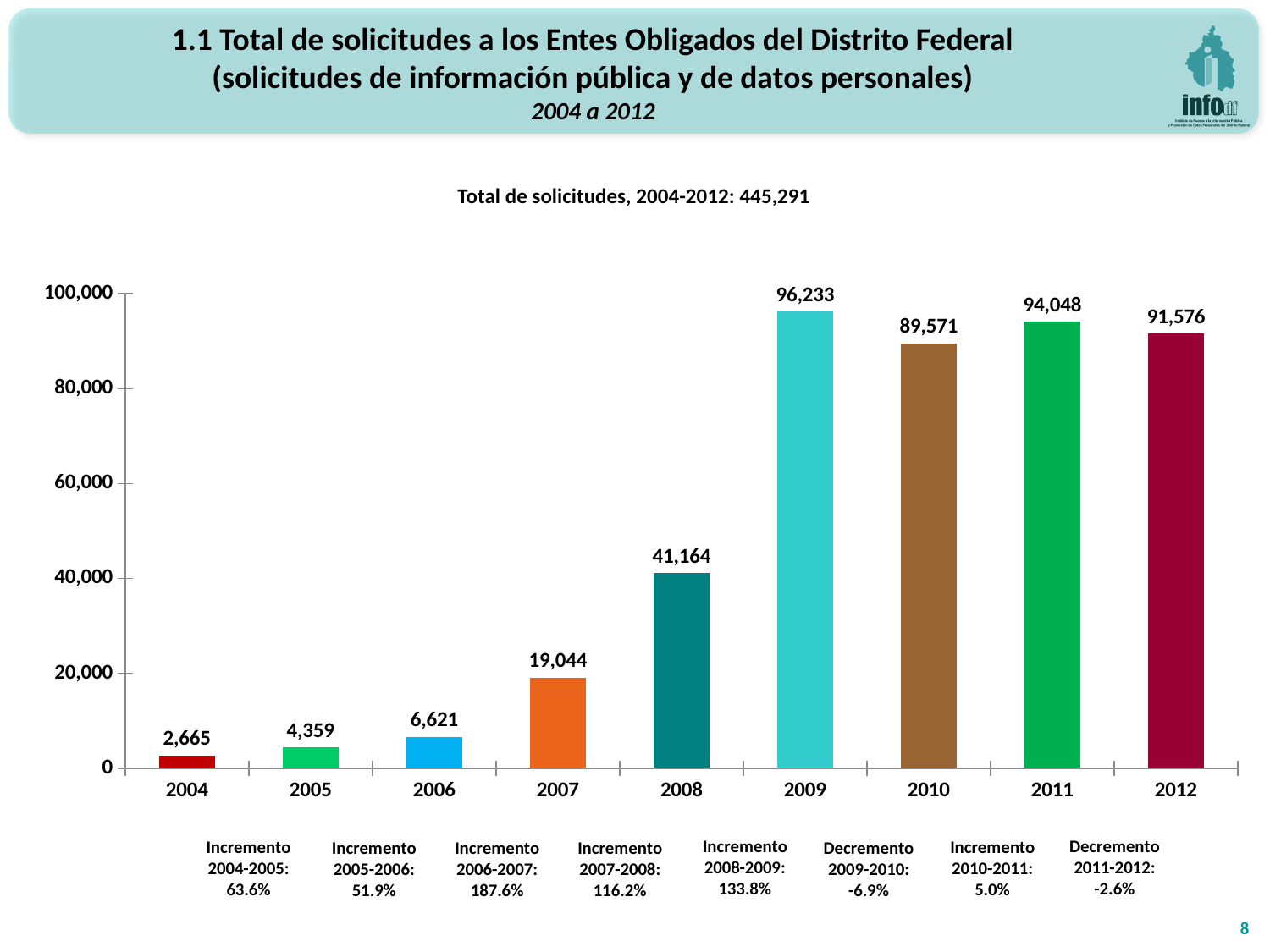
Which year has the highest value? 2009 What is the value for 2007? 19,044 Is the value for 2010 greater or less than 80,000? greater Which year has the lowest value? 2004 What is the value for 2004? 2,665 What kind of chart is shown on the slide? bar chart What is the difference between the values for 2011 and 2010? 4,477 How many years are shown on the x axis? 9 Do the values rise or fall from 2004 to 2009? rise What total for 2004-2012 is stated above the chart? 445,291 What is the value for 2009? 96,233 Which is larger, the value for 2008 or the value for 2012? 2012